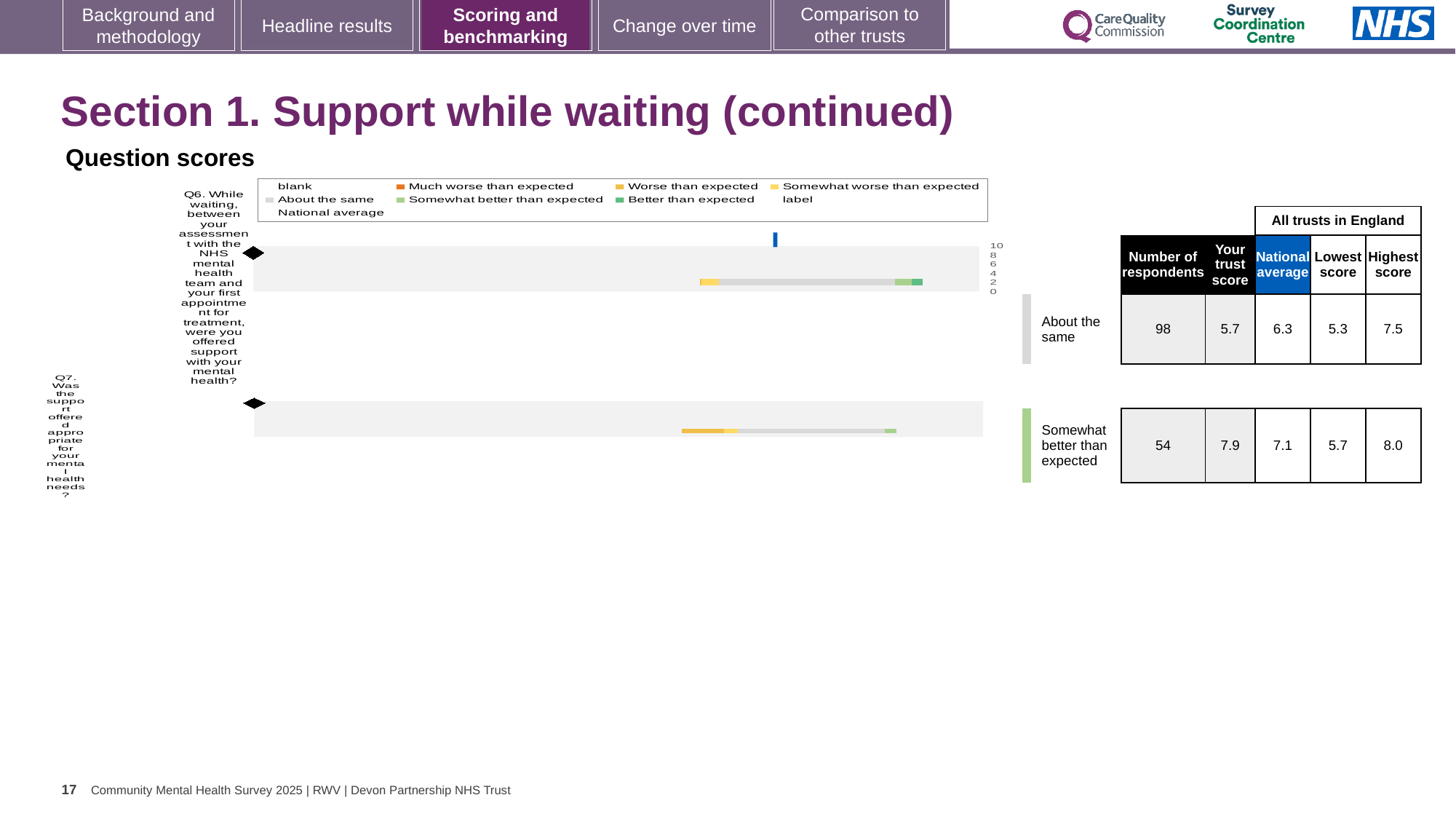
What is the difference between the trust score and the national average for Q7? 0.8 What kind of chart is used to show the question scores? bar chart How many entries does the legend of the question scores chart list? 9 What is the maximum value shown on the score axis of the question scores chart? 10 What is the national average score for Q7 (was the support offered appropriate)? 7.1 Which benchmark category is Q7 placed in? Somewhat better than expected What is the highest score across all trusts in England for Q6? 7.5 Which question has the higher trust score, Q6 or Q7? Q7 How many respondents answered Q7? 54 Which legend entry in the question scores chart is shown in dark blue? National average How many questions (categories) are plotted in the question scores chart? 2 What is the trust score for Q6 (support with mental health while waiting)? 5.7